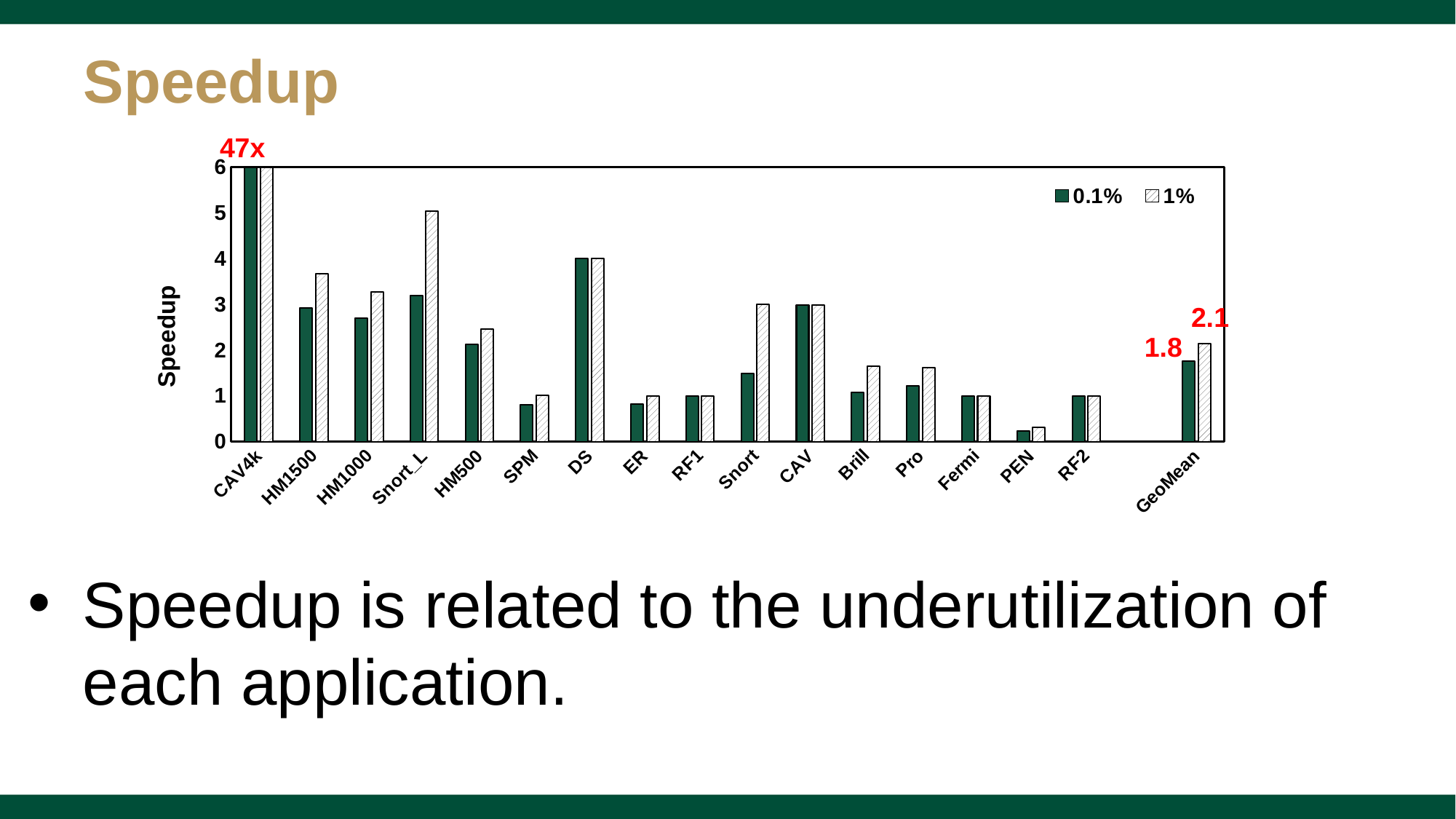
For Snort, which series has the larger speedup, 0.1% or 1%? 1% How many categories are shown on the x axis? 17 What speedup value is labelled above the CAV4k bars? 47x Is the 1% speedup for HM1500 greater or less than 3? greater What is the GeoMean speedup for the 1% series? 2.1 How many series does the legend list? 2 What kind of chart is shown on the slide? bar chart What is the GeoMean speedup for the 0.1% series? 1.8 Which application has the highest speedup? CAV4k Which application has the lowest speedup for the 0.1% series? PEN What is the difference between the 1% and 0.1% GeoMean speedups? 0.3 What is the label of the y axis? Speedup